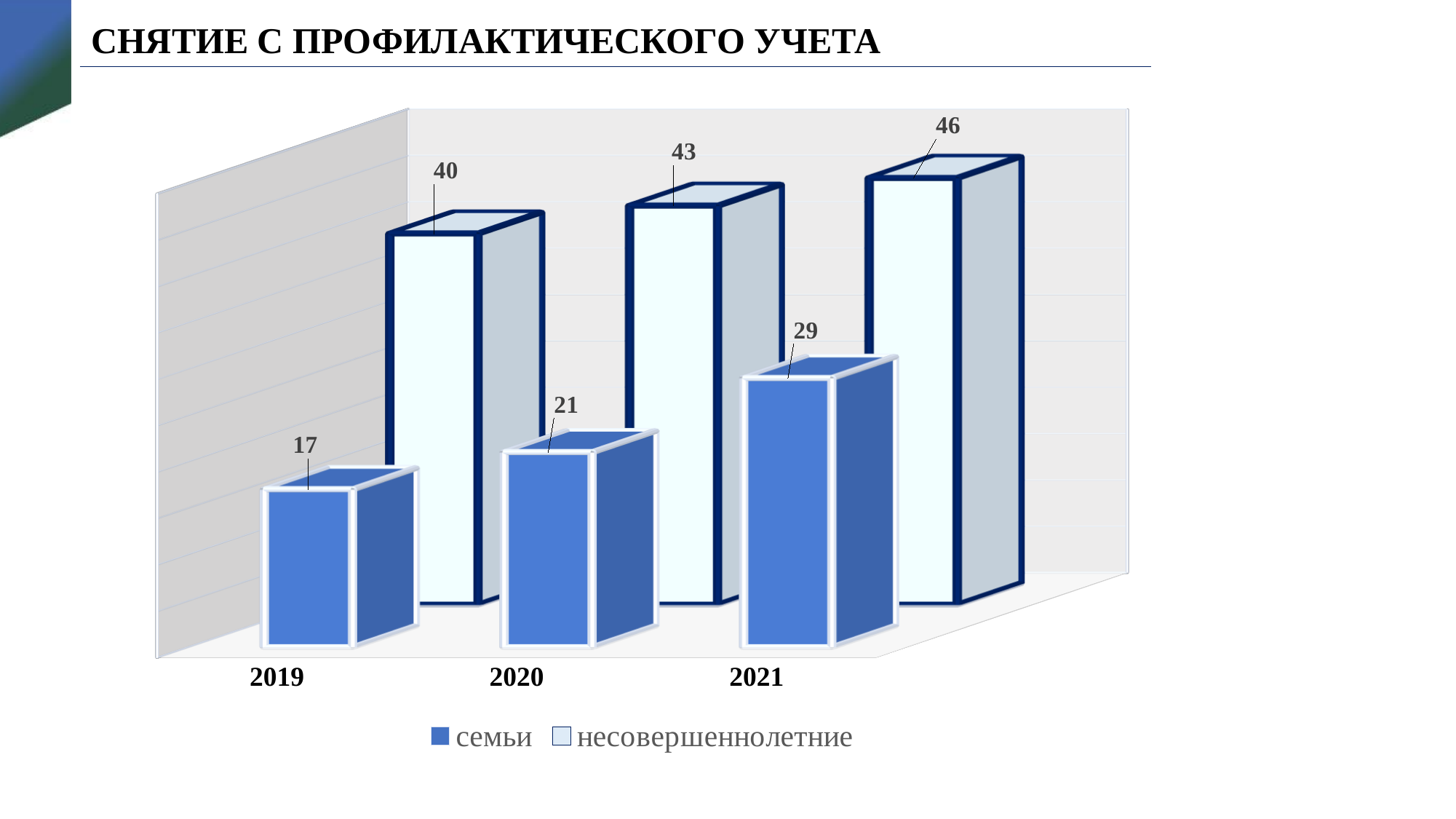
What is the difference between несовершеннолетние and семьи in 2020? 22 What kind of chart is shown on the slide? bar chart How many years are shown on the x axis? 3 What is the value for несовершеннолетние in 2021? 46 How many series does the legend list? 2 What is the value for несовершеннолетние in 2020? 43 In which year is the value for несовершеннолетние highest? 2021 In which year is the value for семьи lowest? 2019 What is the value for семьи in 2019? 17 Do the values for семьи rise or fall from 2019 to 2021? rise What is the value for семьи in 2021? 29 Which is larger in 2019: семьи or несовершеннолетние? несовершеннолетние